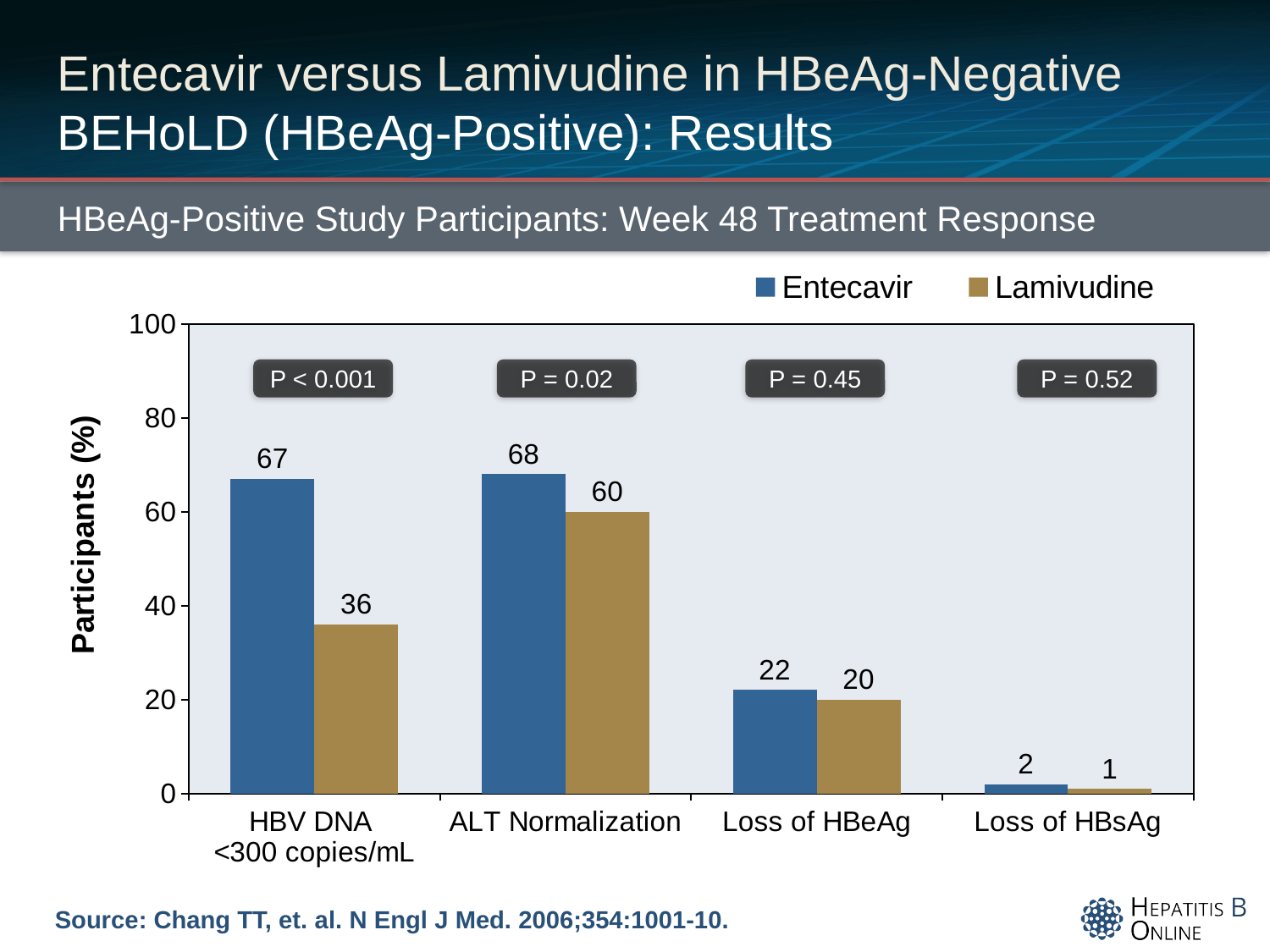
What percentage of Entecavir participants achieved HBV DNA <300 copies/mL? 67 How many series does the legend list? 2 Which category has the lowest Lamivudine value? Loss of HBsAg What kind of chart is shown on the slide? bar chart How many categories are shown on the x axis? 4 What is the Lamivudine value for ALT Normalization? 60 Is the Lamivudine value for HBV DNA <300 copies/mL greater or less than 40? less Which category has the highest Entecavir value? ALT Normalization What is the Lamivudine value for Loss of HBeAg? 20 What is the difference between the Entecavir and Lamivudine values for HBV DNA <300 copies/mL? 31 Which is larger for ALT Normalization, the Entecavir value or the Lamivudine value? Entecavir What P value is shown above the Loss of HBeAg bars? P = 0.45